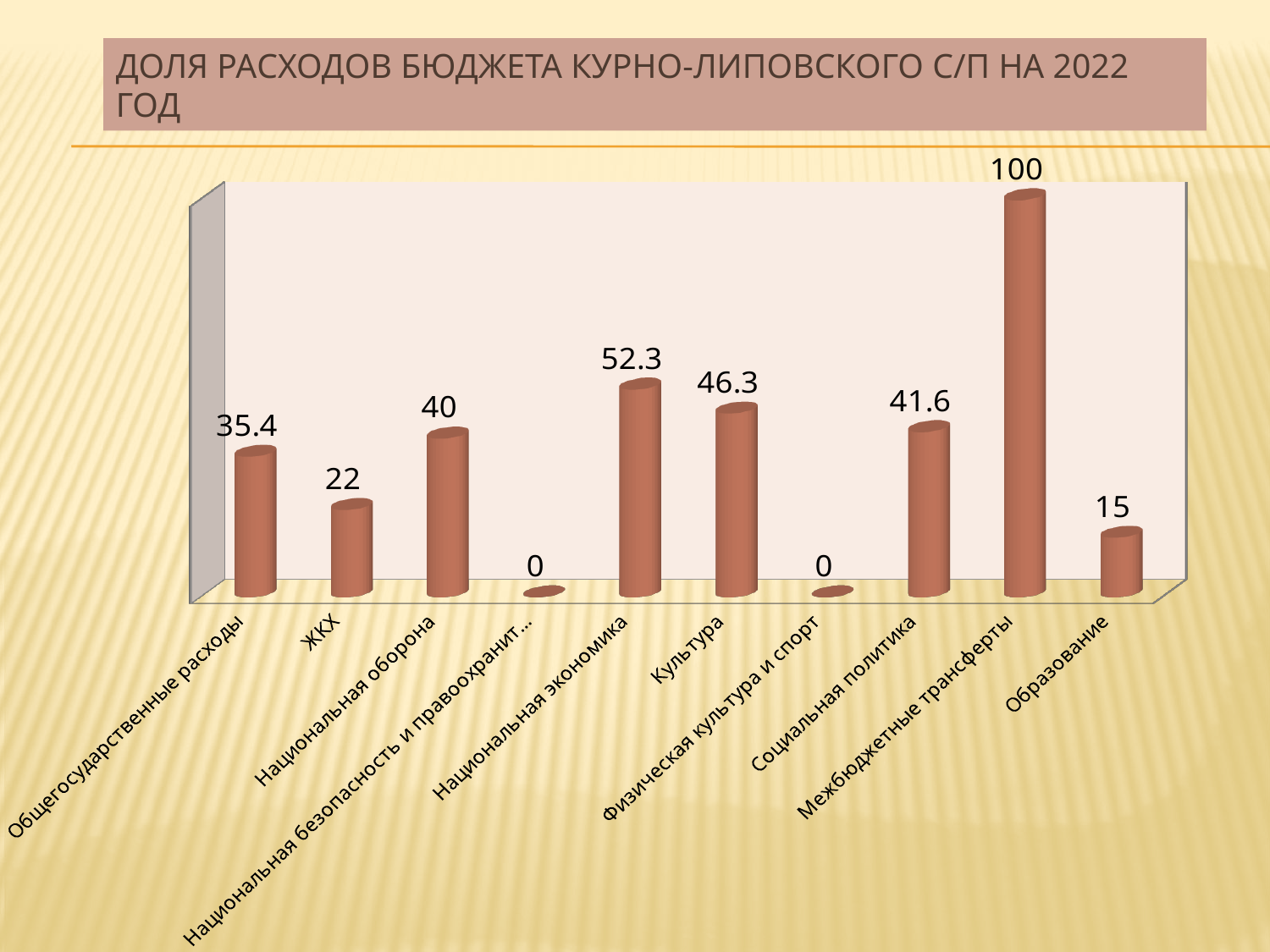
What is the value for Образование? 15 What is the value for Национальная экономика? 52.3 How many categories are shown on the chart? 10 What is the title of the chart on the slide? ДОЛЯ РАСХОДОВ БЮДЖЕТА КУРНО-ЛИПОВСКОГО С/П НА 2022 ГОД What is the value for Социальная политика? 41.6 Which category has the highest value? Межбюджетные трансферты How many categories have a value of 0? 2 What is the difference between the values for Национальная оборона and Общегосударственные расходы? 4.6 What kind of chart is shown on the slide? Bar chart Which is larger, the value for Культура or the value for Социальная политика? Культура What is the value for ЖКХ? 22 What is the difference between the values for Межбюджетные трансферты and Культура? 53.7